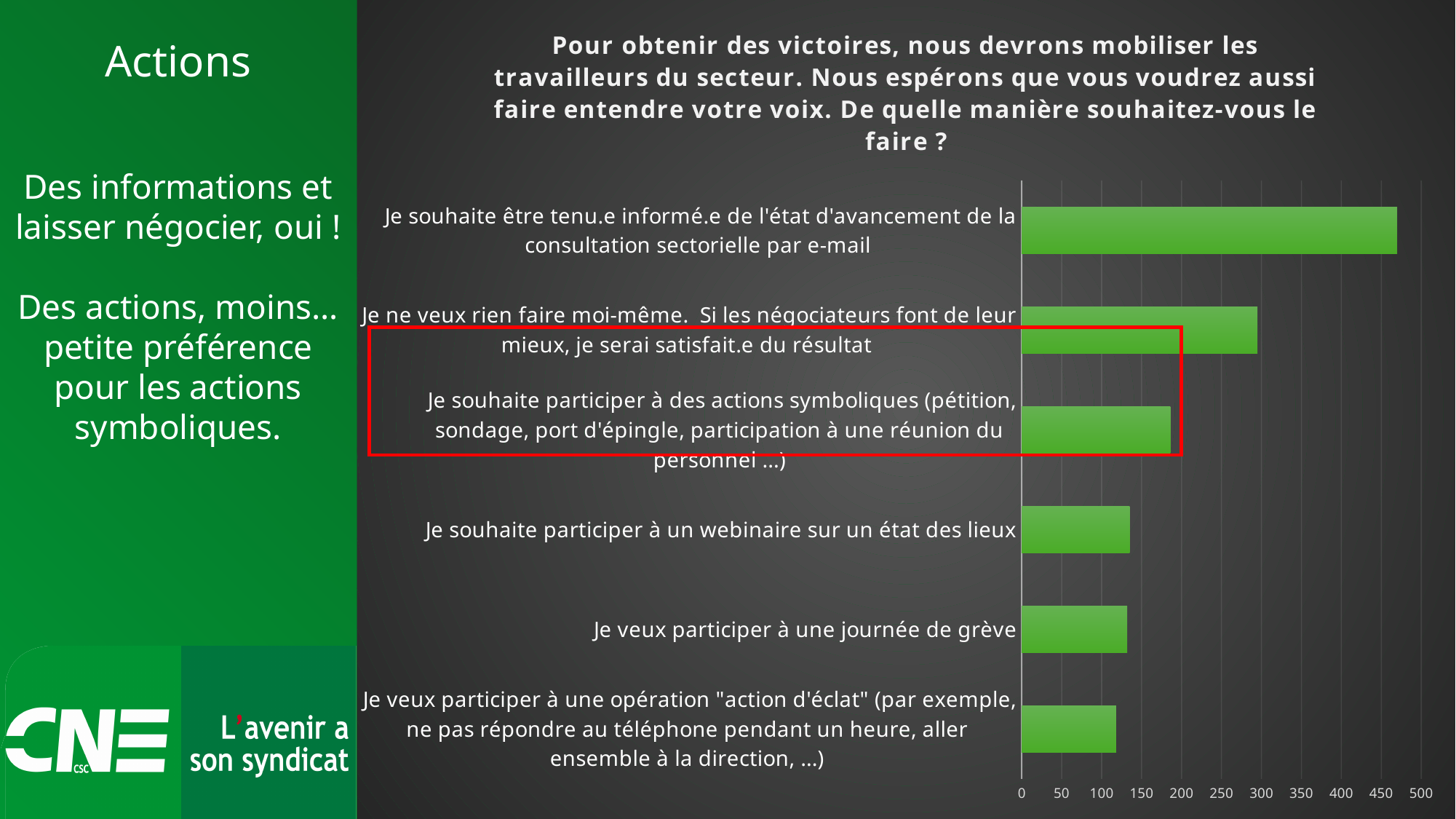
Which response option has the highest value in the chart? Je souhaite être tenu.e informé.e de l'état d'avancement de la consultation sectorielle par e-mail Is the value for "Je veux participer à une opération 'action d'éclat'" greater or less than 150? less Is the value for "Je ne veux rien faire moi-même. Si les négociateurs font de leur mieux, je serai satisfait.e du résultat" greater or less than 250? greater Is the value for "Je souhaite participer à des actions symboliques" greater or less than 150? greater What colour are the bars in the chart? green How many categories (response options) are shown in the chart? 6 What kind of chart is shown on the slide? bar chart What is the highest tick value shown on the horizontal axis of the chart? 500 Which is larger: the value for "Je veux participer à une journée de grève" or the value for "Je souhaite être tenu.e informé.e ... par e-mail"? Je souhaite être tenu.e informé.e ... par e-mail Which is larger: the value for "Je ne veux rien faire moi-même" or the value for "Je souhaite participer à des actions symboliques"? Je ne veux rien faire moi-même